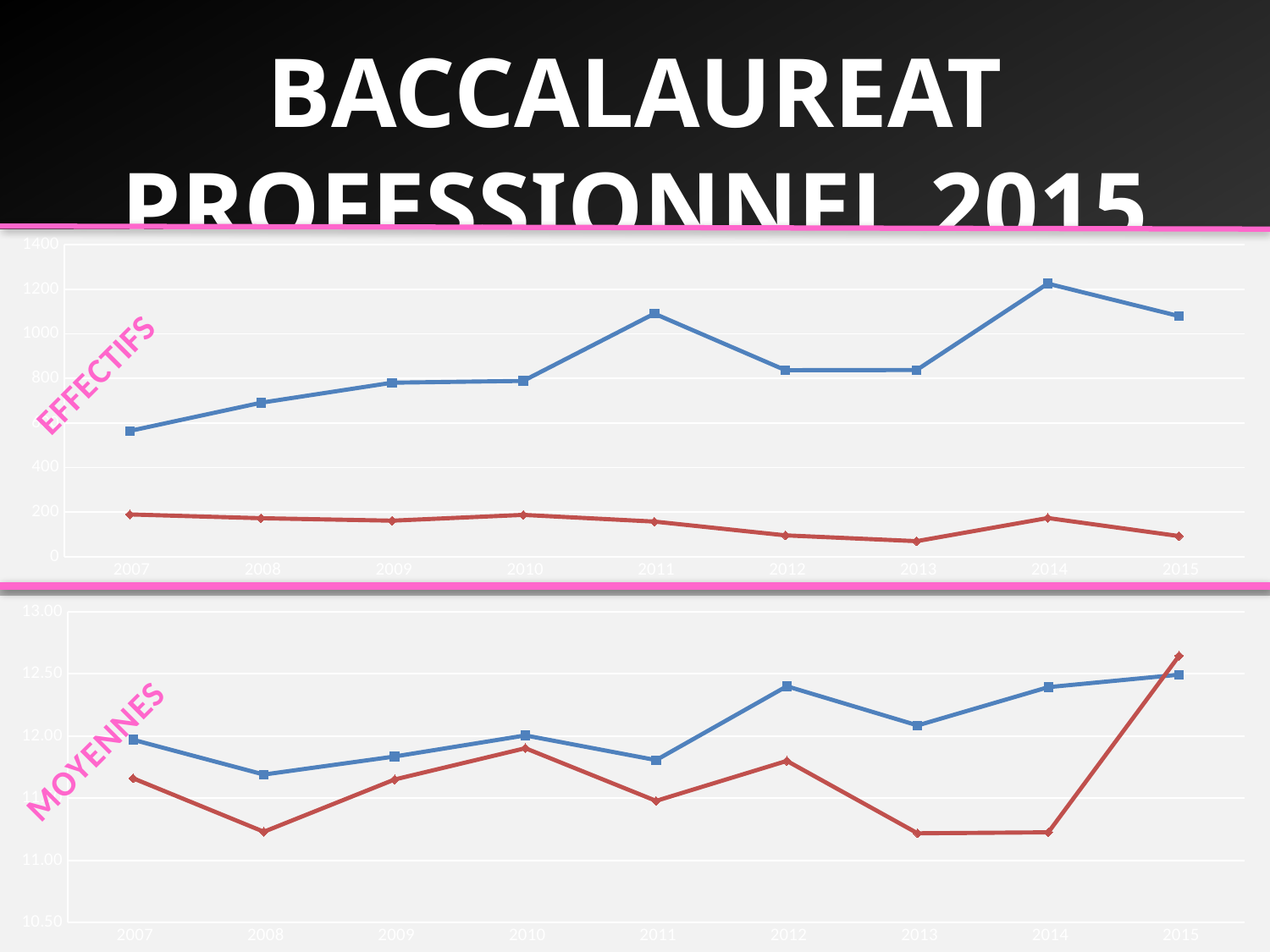
In the top chart (EFFECTIFS), is the blue line higher in 2011 or in 2012? 2011 In the bottom chart (MOYENNES), which line is higher in 2015, the blue line or the red line? the red line In the top chart (EFFECTIFS), in which year is the blue line at its lowest value? 2007 In the top chart (EFFECTIFS), in which year does the blue line reach its highest value? 2014 In the top chart (EFFECTIFS), is the value of the blue line for 2014 greater or less than 1200? greater In the top chart (EFFECTIFS), how many years are shown on the x axis? 9 In the top chart (EFFECTIFS), is the value of the blue line for 2007 greater or less than 600? less What kind of chart is the top chart labelled EFFECTIFS? line chart In the bottom chart (MOYENNES), is the value of the blue line for 2008 greater or less than 12.00? less In the bottom chart (MOYENNES), in which year does the red line reach its highest value? 2015 In the top chart (EFFECTIFS), does the blue line rise or fall from 2007 to 2011? rises